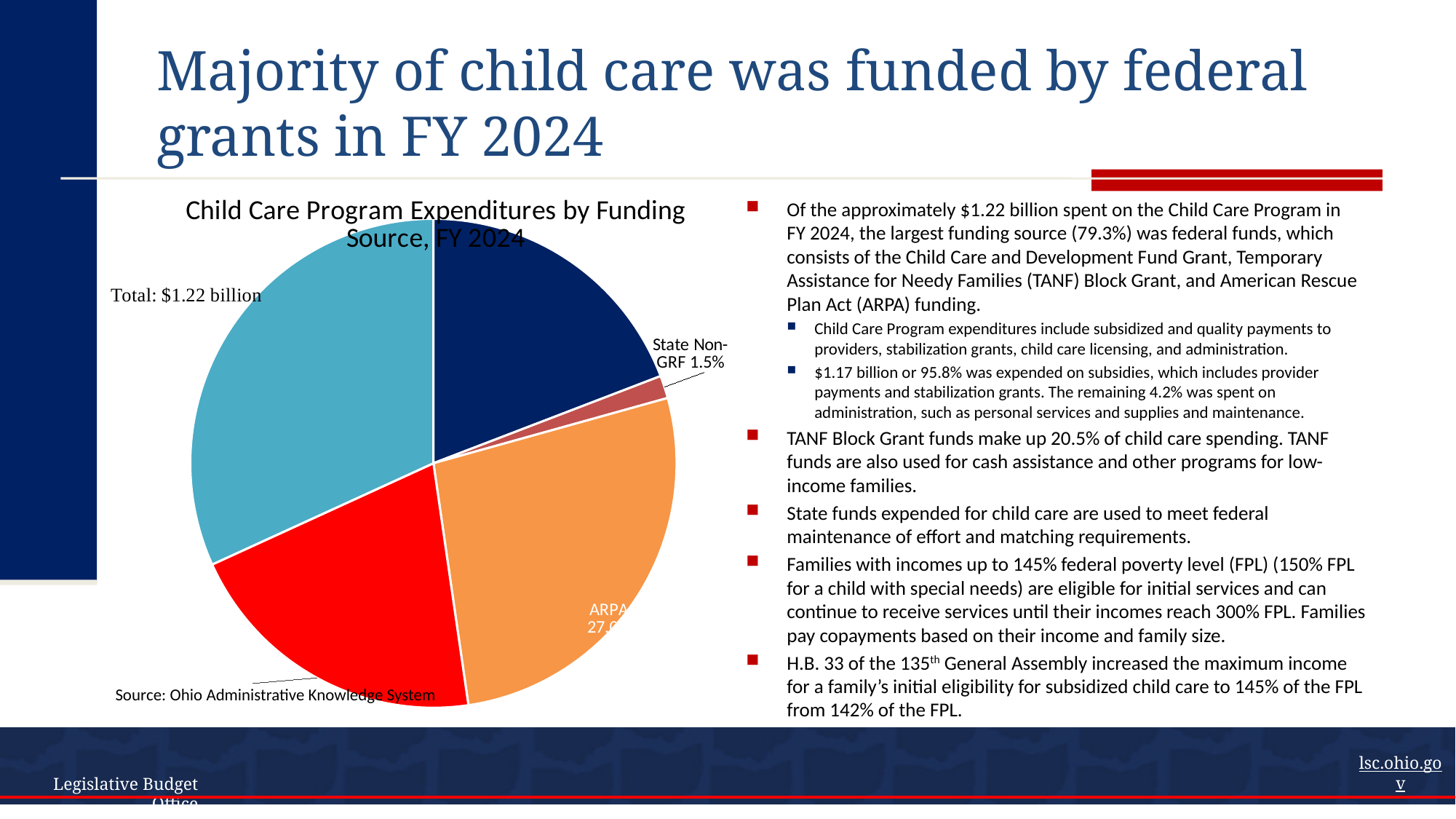
What total amount is shown on the chart? $1.22 billion What share of the pie does State Non-GRF represent? 1.5% What source is cited below the chart? Ohio Administrative Knowledge System How many slices does the pie chart have? 5 What kind of chart is shown on the slide? pie chart What is the title of the chart? Child Care Program Expenditures by Funding Source, FY 2024 Which slice is larger, ARPA or State Non-GRF? ARPA Which labeled slice is the smallest in the pie chart? State Non-GRF